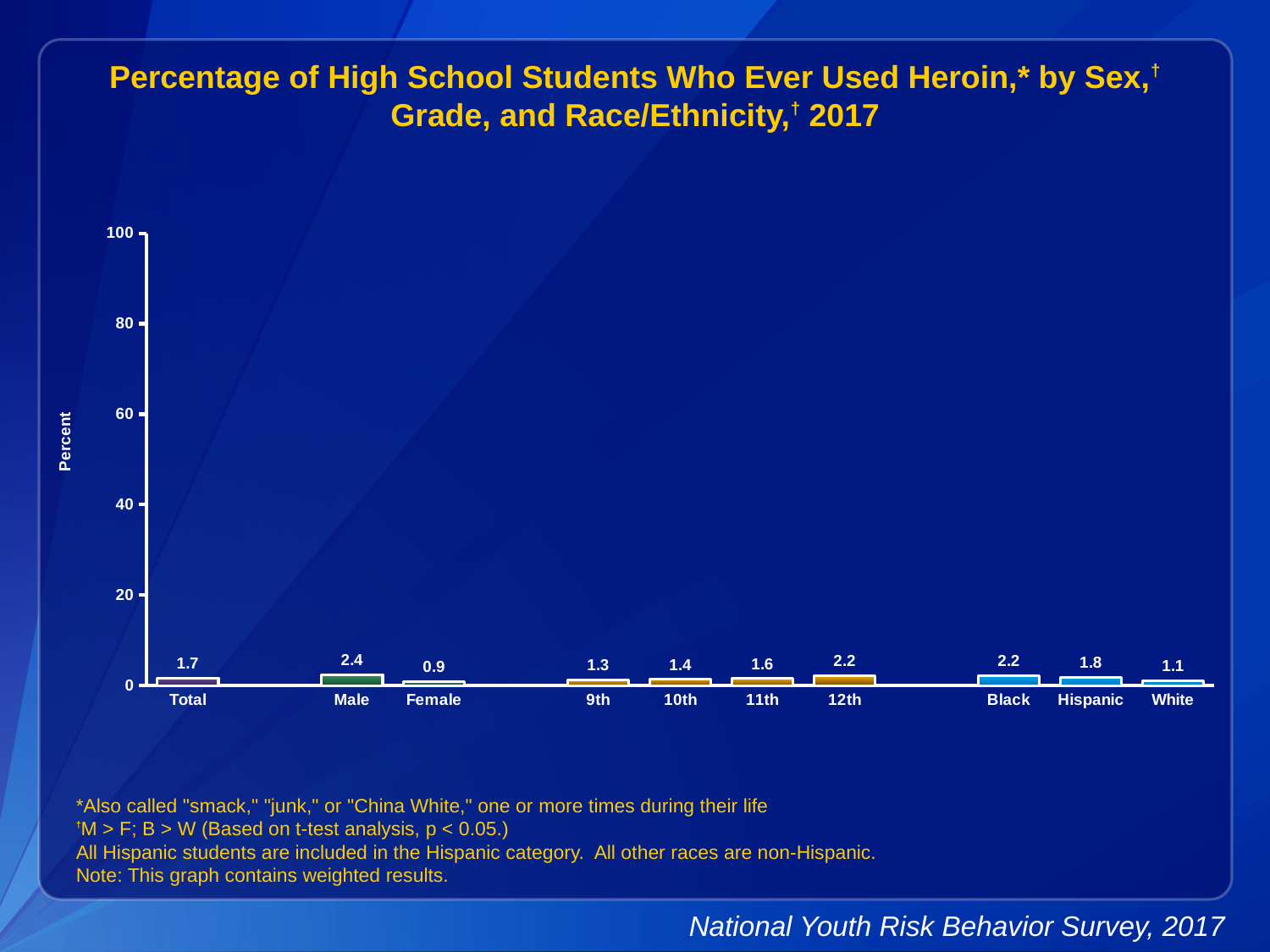
What is the value for Male? 2.4 What is the value for 12th grade? 2.2 What is the value for Hispanic? 1.8 Which is larger, the value for Black or the value for White? Black What is the difference between the values for Male and Female? 1.5 Which category has the highest value? Male What kind of chart is this? Bar chart Which category has the lowest value? Female Do the values rise or fall from 9th grade to 12th grade? Rise How many categories are shown on the x axis? 10 What is the value for Female? 0.9 What is the value for Total? 1.7